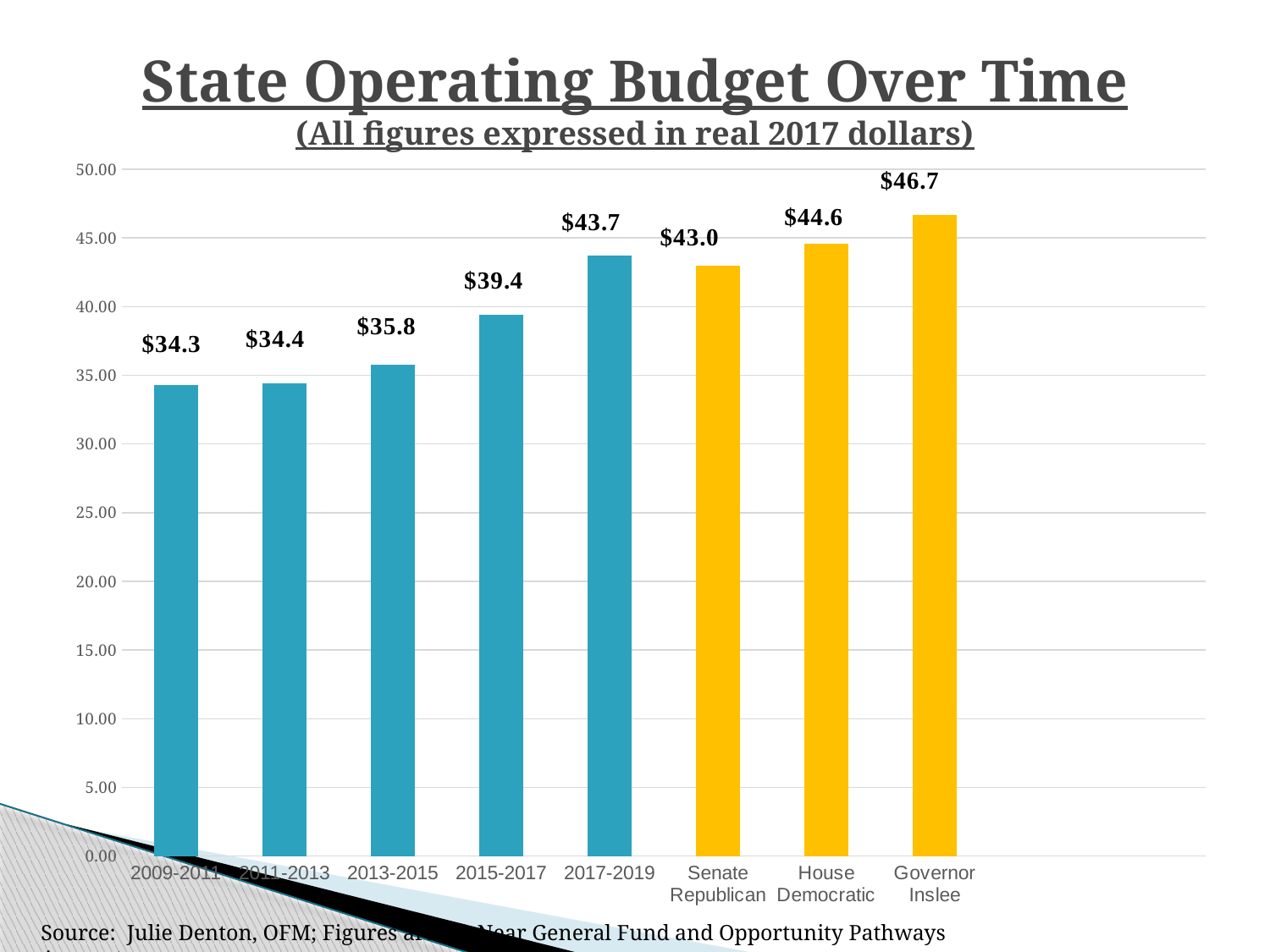
Which is larger, the value for 2017-2019 or the value for Senate Republican? 2017-2019 How many bars are shown in the chart? 8 What is the difference between the Governor Inslee value and the 2017-2019 value? $3.0 What is the difference between the House Democratic value and the Senate Republican value? $1.6 Do the values rise or fall from 2009-2011 to 2017-2019? rise Which category has the highest value? Governor Inslee What kind of chart is shown on the slide? bar chart What is the value for the Senate Republican bar? $43.0 Is the value for 2013-2015 greater or less than 40.00? less What is the value for 2015-2017? $39.4 Which category has the lowest value? 2009-2011 What is the value for 2009-2011? $34.3